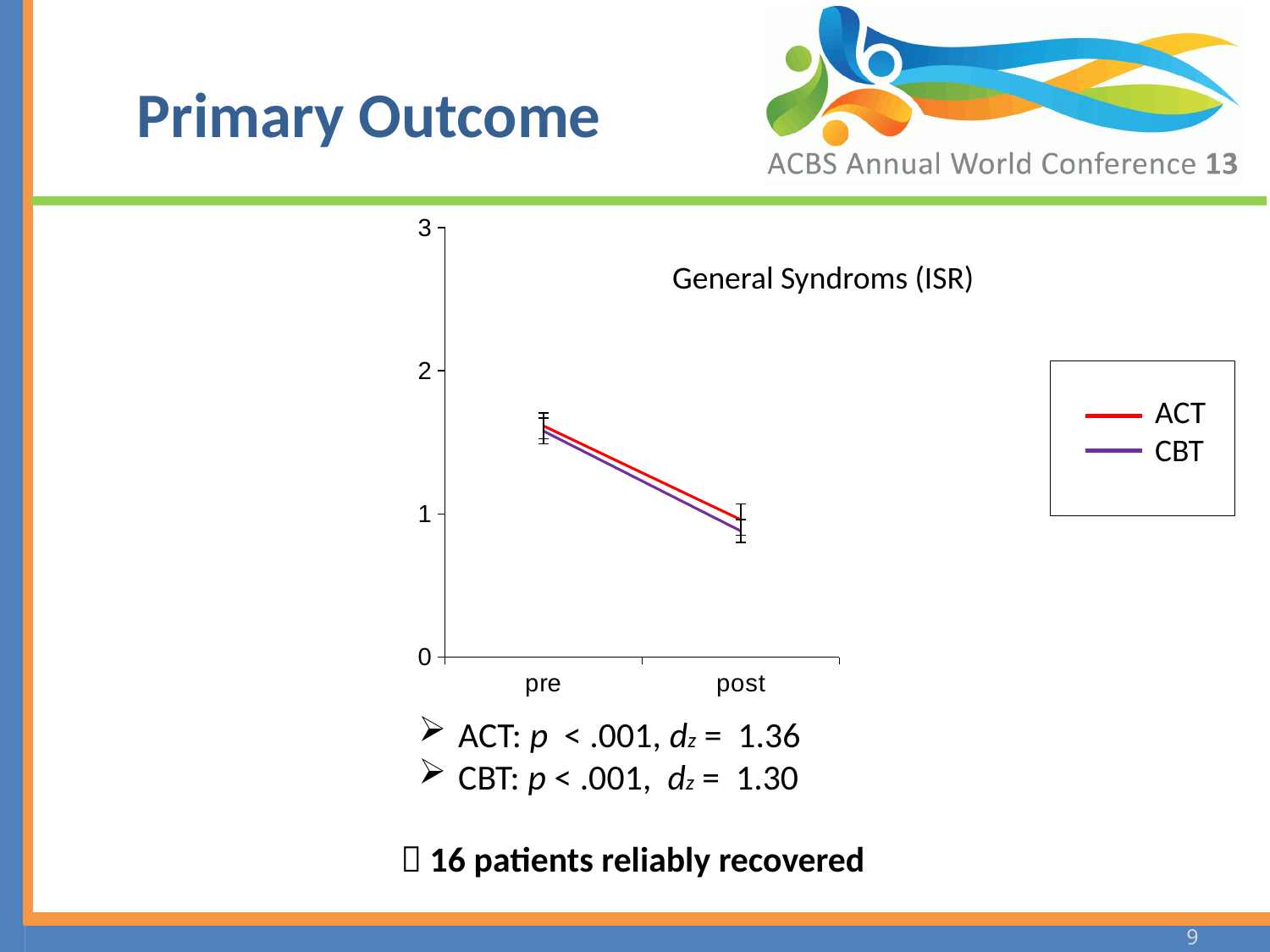
Does the CBT line rise or fall from pre to post? fall Is the value for ACT at pre greater or less than 1? greater What kind of chart is shown on the slide? line chart Does the ACT line rise or fall from pre to post? fall Which series is drawn in red in the chart? ACT For the CBT series, which time point has the higher value, pre or post? pre Is the value for CBT at pre greater or less than 2? less Is the value for ACT at post greater or less than 2? less What is the highest value shown on the y axis of the chart? 3 What is the title of the chart? General Syndroms (ISR) How many time points are shown on the x axis of the chart? 2 How many series does the chart legend list? 2